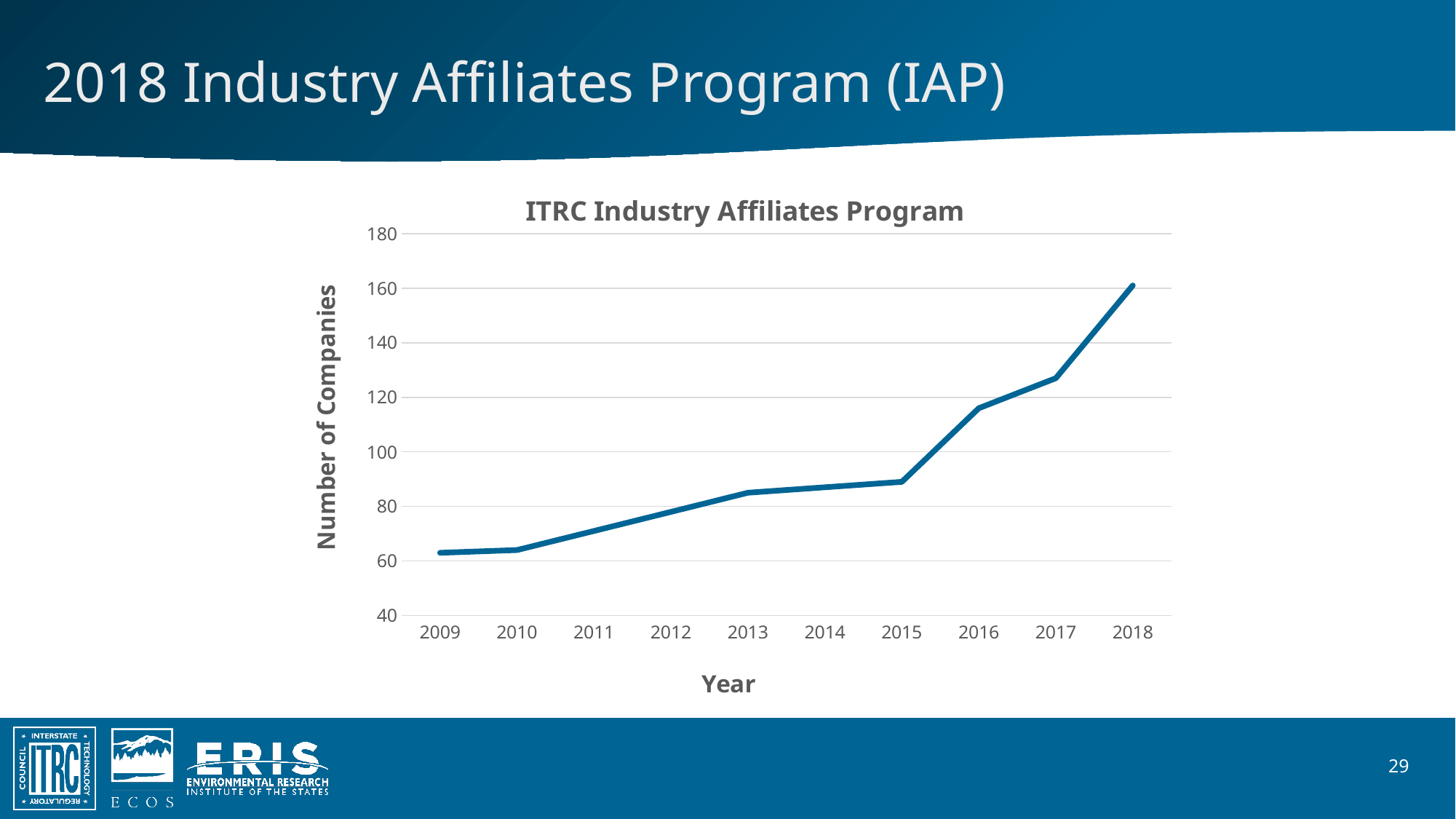
Is the value for 2018 greater or less than 140? greater Which year has the highest number of companies? 2018 Is the value for 2011 greater or less than 80? less What is the title of the chart? ITRC Industry Affiliates Program How many years are plotted on the x axis? 10 Do the values generally rise or fall from 2009 to 2018? rise Is the value for 2016 greater or less than 100? greater What kind of chart is shown on the slide? line chart Which year has the larger number of companies, 2013 or 2016? 2016 What is the label of the vertical axis? Number of Companies